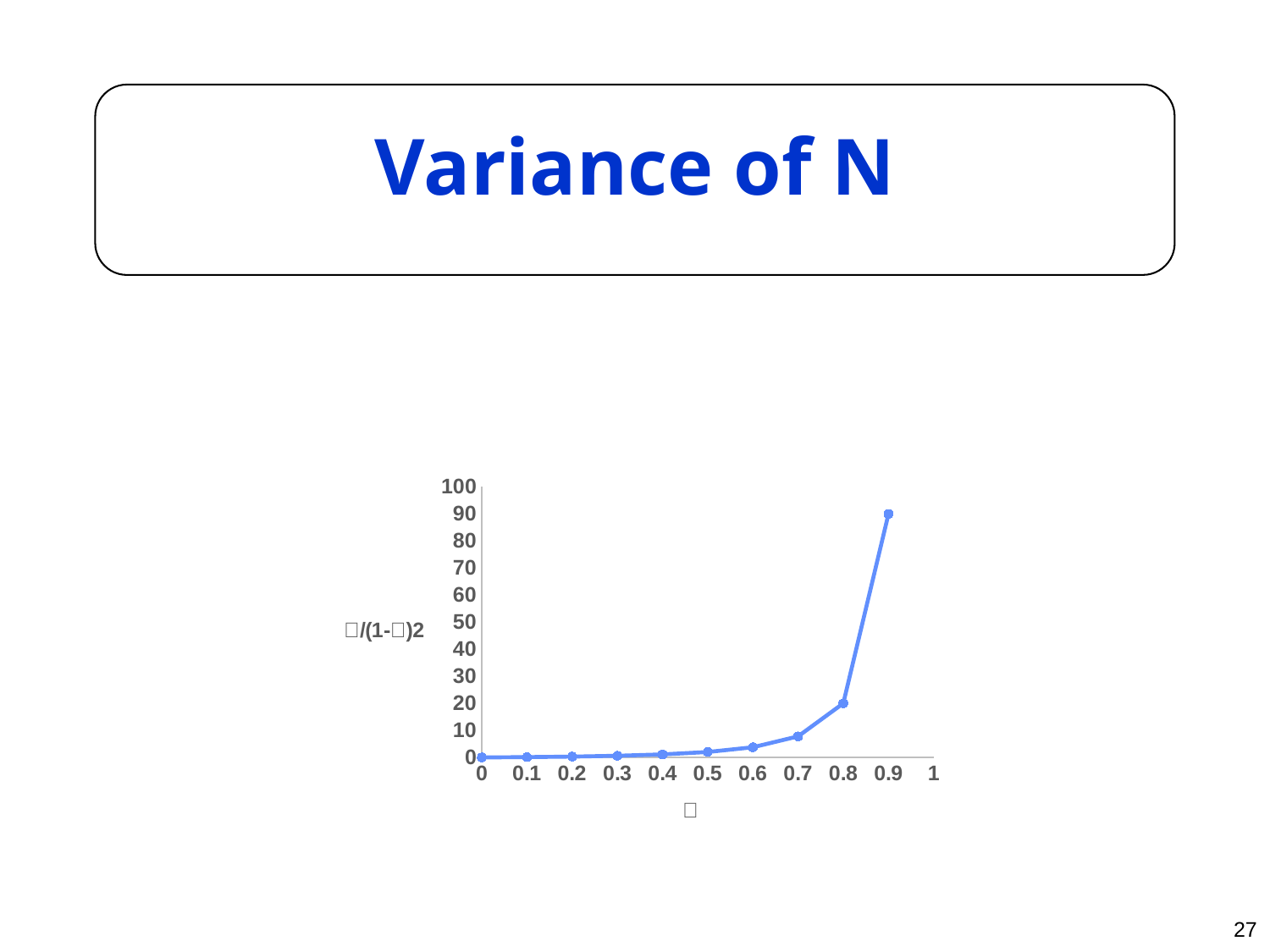
How many data points are plotted on the line? 10 Is the value at x = 0.9 greater or less than 50? greater What is the difference between the values at x = 0.9 and x = 0.8? 70 Which is larger, the value at x = 0.8 or the value at x = 0.9? 0.9 At which x-axis value does the line reach its highest point? 0.9 Is the value at x = 0.6 greater or less than 10? less What is the plotted value at x = 0.8? 20 What is the plotted value at x = 0? 0 What is the title of the slide containing the chart? Variance of N What kind of chart is shown on the slide? line chart Do the plotted values rise or fall as x increases from 0 to 0.9? rise What is the plotted value at x = 0.9? 90